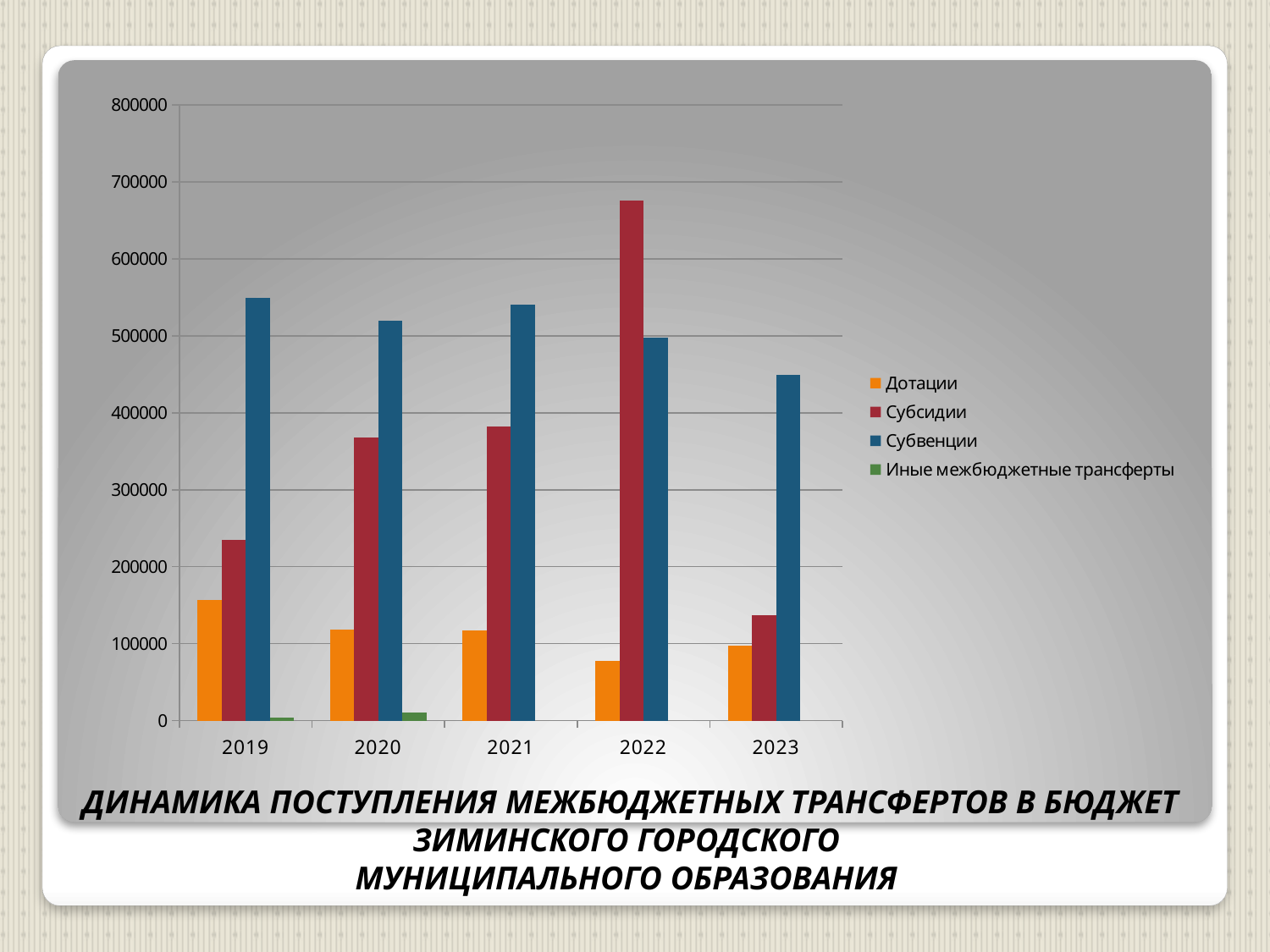
How many series does the legend list? 4 Is the value for Дотации in 2022 greater or less than 100000? less In which year is the value for Субсидии the highest? 2022 In which year is the value for Дотации the highest? 2019 In 2022, which is larger: Субсидии or Субвенции? Субсидии In 2019, which is larger: Дотации or Субсидии? Субсидии Is the value for Субсидии in 2022 greater or less than 600000? greater What kind of chart is shown on the slide? bar chart Does the value for Дотации rise or fall from 2019 to 2022? fall How many years are shown on the x axis? 5 In which year is the value for Субвенции the lowest? 2023 Is the value for Субвенции in 2019 greater or less than 500000? greater